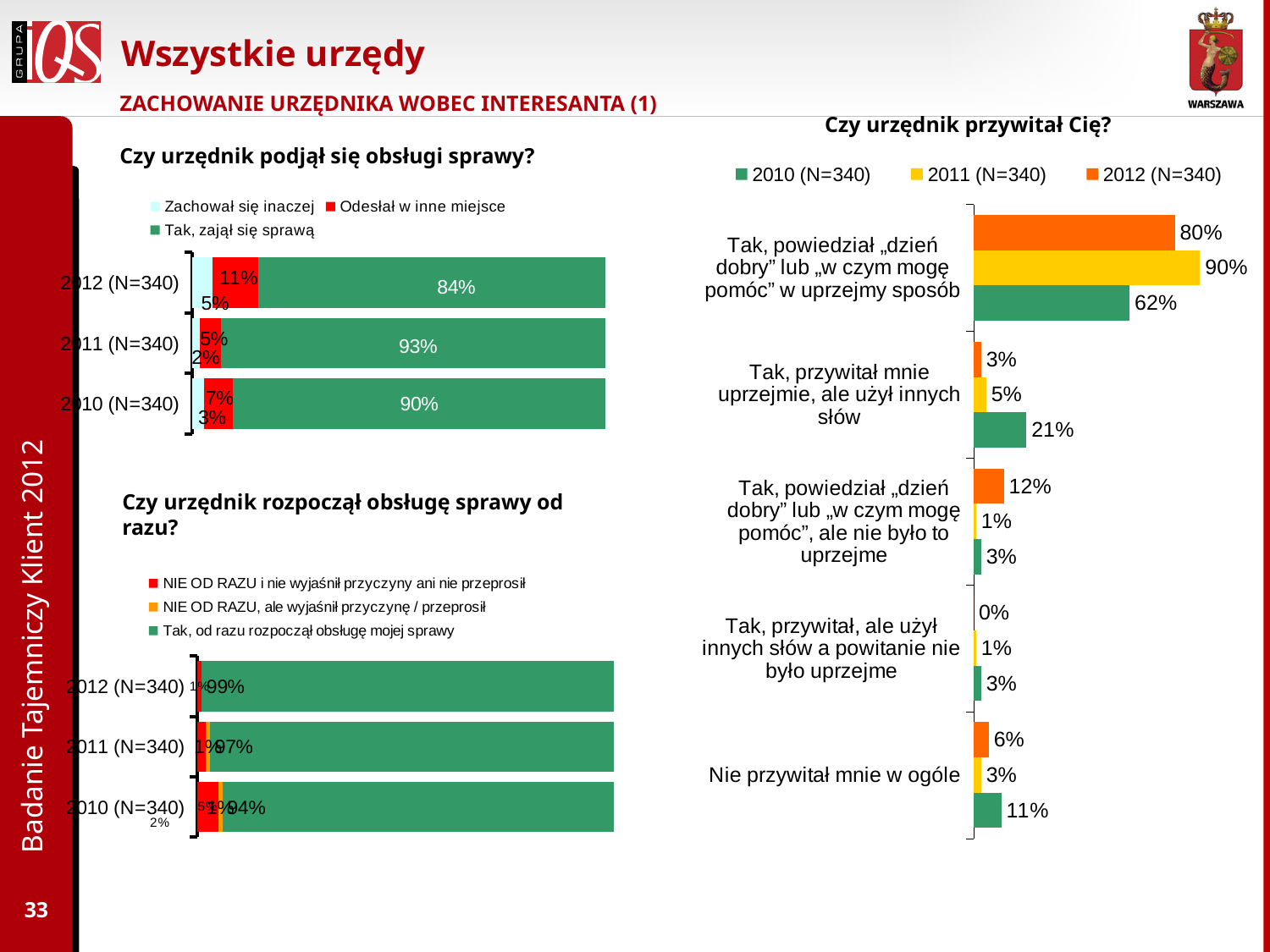
In the chart "Czy urzędnik rozpoczął obsługę sprawy od razu?", what is the "Tak, od razu rozpoczął obsługę mojej sprawy" value for 2012 (N=340)? 99% In the chart "Czy urzędnik przywitał Cię?", what is the 2012 (N=340) value for "Nie przywitał mnie w ogóle"? 6% In the chart "Czy urzędnik przywitał Cię?", how many series does the legend list? 3 In the chart "Czy urzędnik przywitał Cię?", how many categories are shown? 5 In the chart "Czy urzędnik podjął się obsługi sprawy?", which year has the lowest "Tak, zajął się sprawą" value? 2012 (N=340) What kind of chart is "Czy urzędnik przywitał Cię?"? Bar chart In the chart "Czy urzędnik podjął się obsługi sprawy?", what is the "Odesłał w inne miejsce" value for 2012 (N=340)? 11% In the chart "Czy urzędnik przywitał Cię?", which year has the highest value for "Tak, powiedział „dzień dobry” lub „w czym mogę pomóc” w uprzejmy sposób"? 2011 (N=340) In the chart "Czy urzędnik podjął się obsługi sprawy?", what is the "Tak, zajął się sprawą" value for 2011 (N=340)? 93% In the chart "Czy urzędnik przywitał Cię?", what is the 2010 (N=340) value for "Tak, przywitał mnie uprzejmie, ale użył innych słów"? 21% In the chart "Czy urzędnik przywitał Cię?", what is the difference between the 2011 and 2010 values for "Tak, powiedział „dzień dobry” lub „w czym mogę pomóc” w uprzejmy sposób"? 28% In the chart "Czy urzędnik przywitał Cię?", what is the 2011 (N=340) value for "Tak, powiedział „dzień dobry” lub „w czym mogę pomóc” w uprzejmy sposób"? 90%